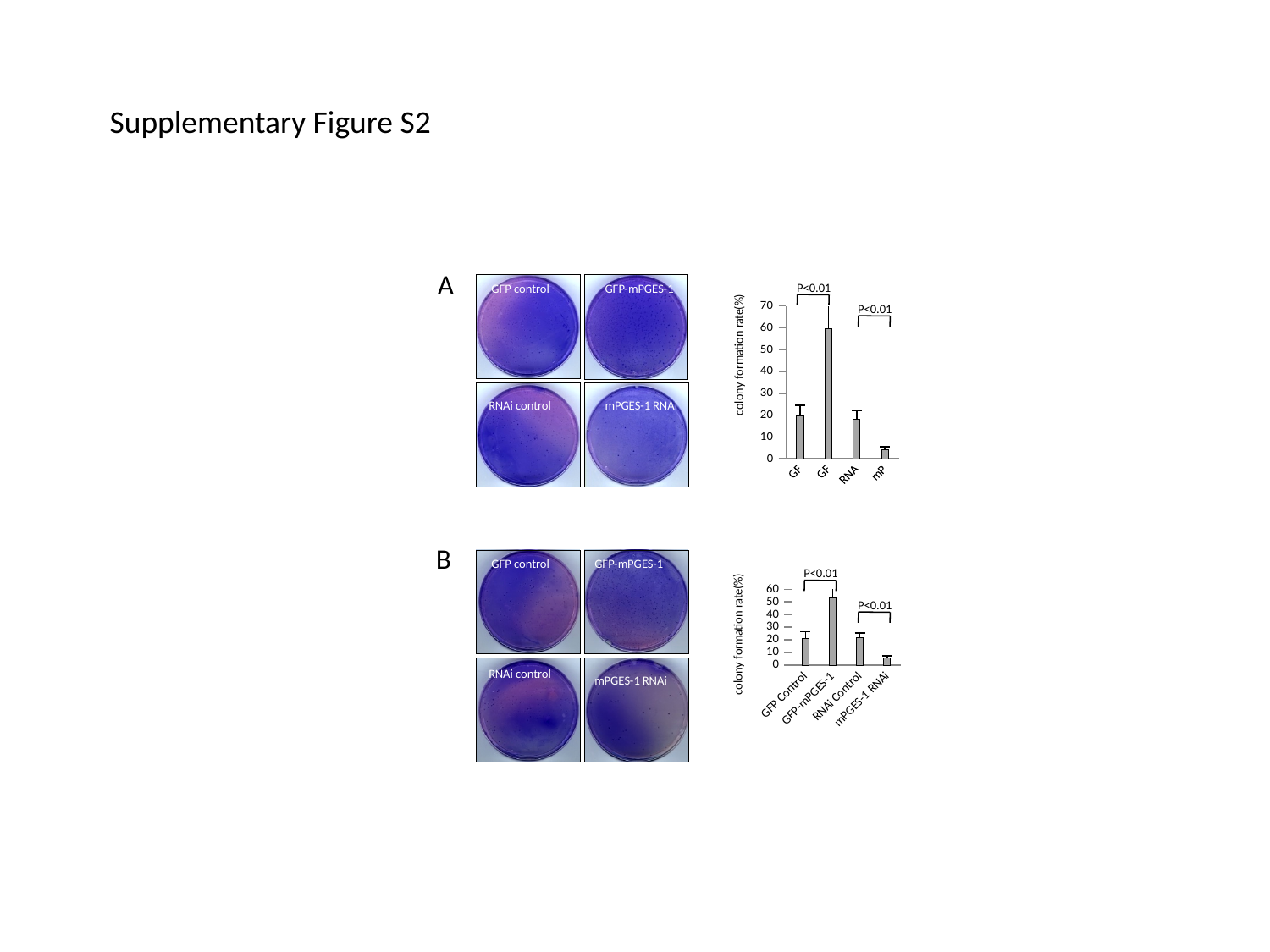
In the panel A chart, is the value of the second (tallest) bar greater or less than 50? greater In the panel A chart, how many bars are plotted? 4 In the panel B chart, how many categories are plotted on the x axis? 4 In the panel B chart, which is larger, the value for GFP-mPGES-1 or the value for RNAi Control? GFP-mPGES-1 In the panel B chart, what is the label on the y axis? colony formation rate(%) In the panel B chart, which category has the lowest colony formation rate? mPGES-1 RNAi In the panel A chart, what is the highest tick value shown on the y axis? 70 In the panel A chart, what kind of chart is shown? bar chart In the panel B chart, is the value for GFP-mPGES-1 greater or less than 40? greater In the panel B chart, is the value for mPGES-1 RNAi greater or less than 10? less In the panel B chart, which category has the highest colony formation rate? GFP-mPGES-1 In the panel B chart, what kind of chart is shown? bar chart